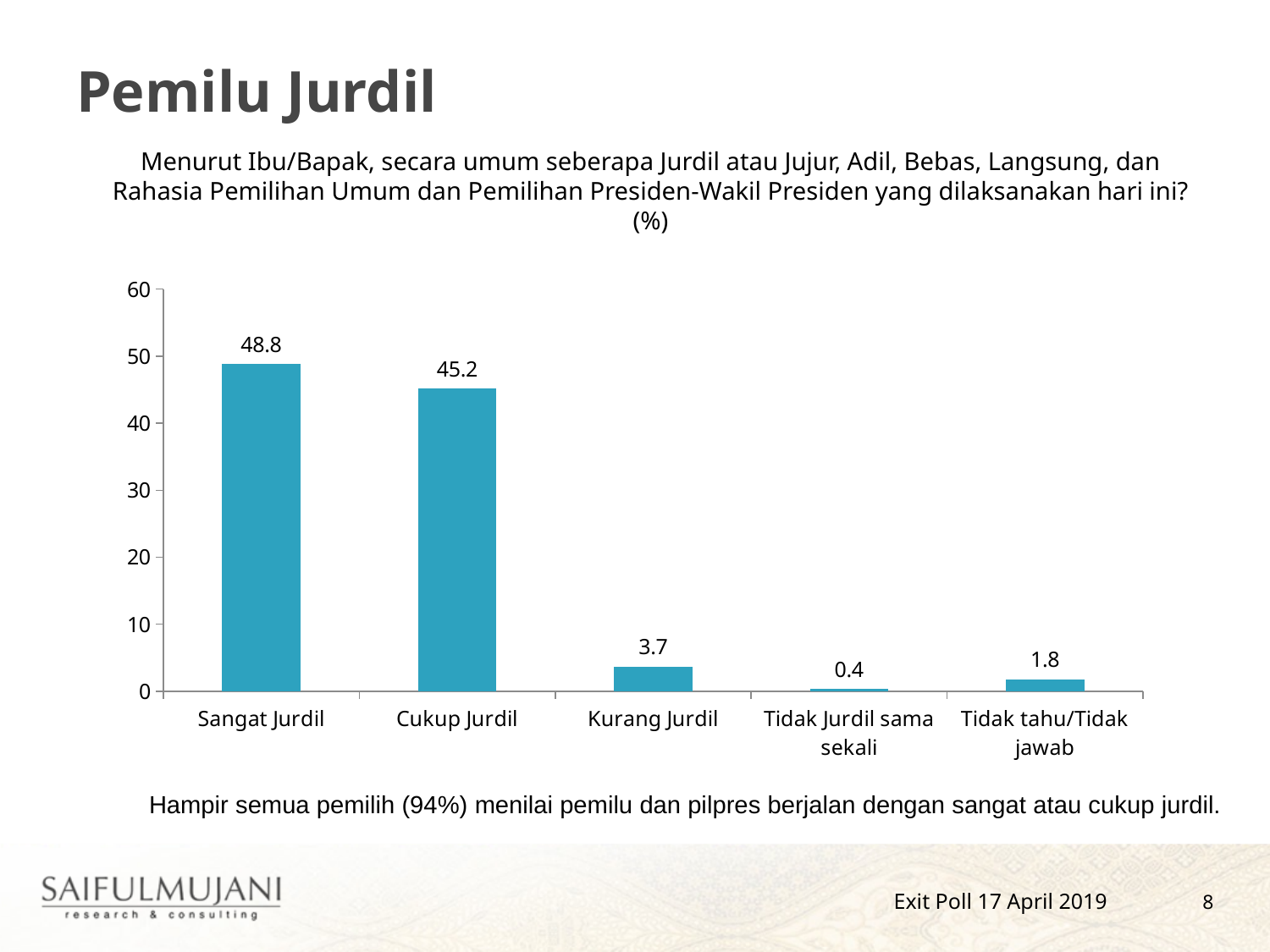
What is the value for Sangat Jurdil? 48.8 What is the value for Tidak Jurdil sama sekali? 0.4 What is the value for Cukup Jurdil? 45.2 What kind of chart is shown on the slide? bar chart Which category has the lowest value? Tidak Jurdil sama sekali Which is larger, the value for Kurang Jurdil or the value for Tidak tahu/Tidak jawab? Kurang Jurdil Is the value for Cukup Jurdil greater or less than 40? greater How many categories are shown on the x axis? 5 What is the difference between the values for Sangat Jurdil and Cukup Jurdil? 3.6 Which category has the highest value? Sangat Jurdil What is the value for Tidak tahu/Tidak jawab? 1.8 What is the value for Kurang Jurdil? 3.7